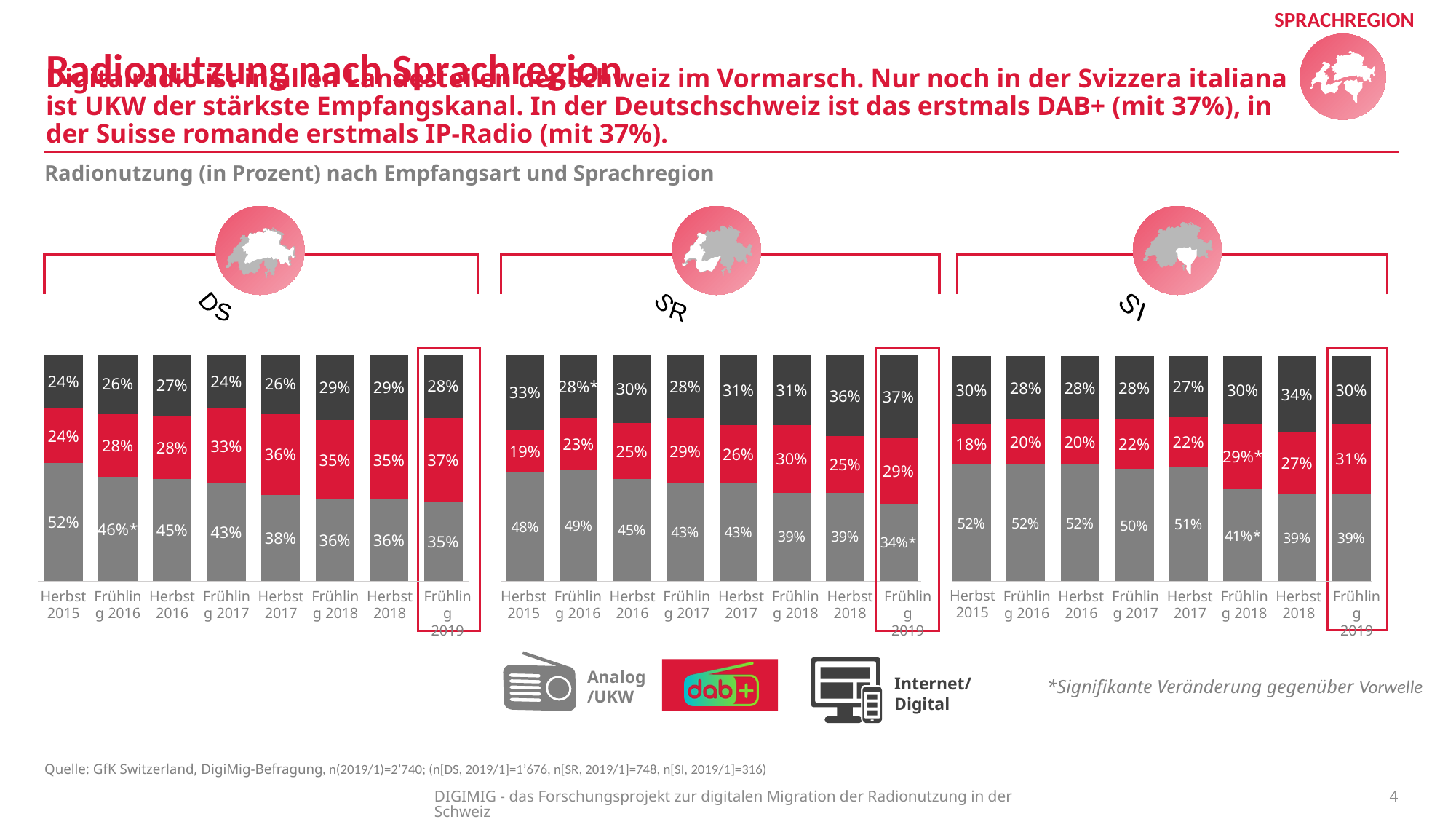
In the SR chart, what is the Internet/Digital value for Frühling 2019? 37% In the DS chart, what is the Analog/UKW value for Herbst 2015? 52% In the DS chart, does the Analog/UKW value rise or fall from Herbst 2015 to Frühling 2019? Fall In the SR chart, which is larger for Herbst 2018: the Analog/UKW value or the Internet/Digital value? Analog/UKW In the DS chart, what is the difference between the Analog/UKW values for Herbst 2015 and Frühling 2019? 17% In the DS chart, what is the DAB+ value for Frühling 2019? 37% What kind of chart is used for the DS, SR and SI data? Stacked bar chart How many series does the legend list? 3 In the SI chart, what is the Analog/UKW value for Frühling 2018? 41%* In the SR chart, which period has the lowest DAB+ value? Herbst 2015 In the SI chart, which period has the highest Internet/Digital value? Herbst 2018 How many periods are shown on the x axis of the SI chart? 8